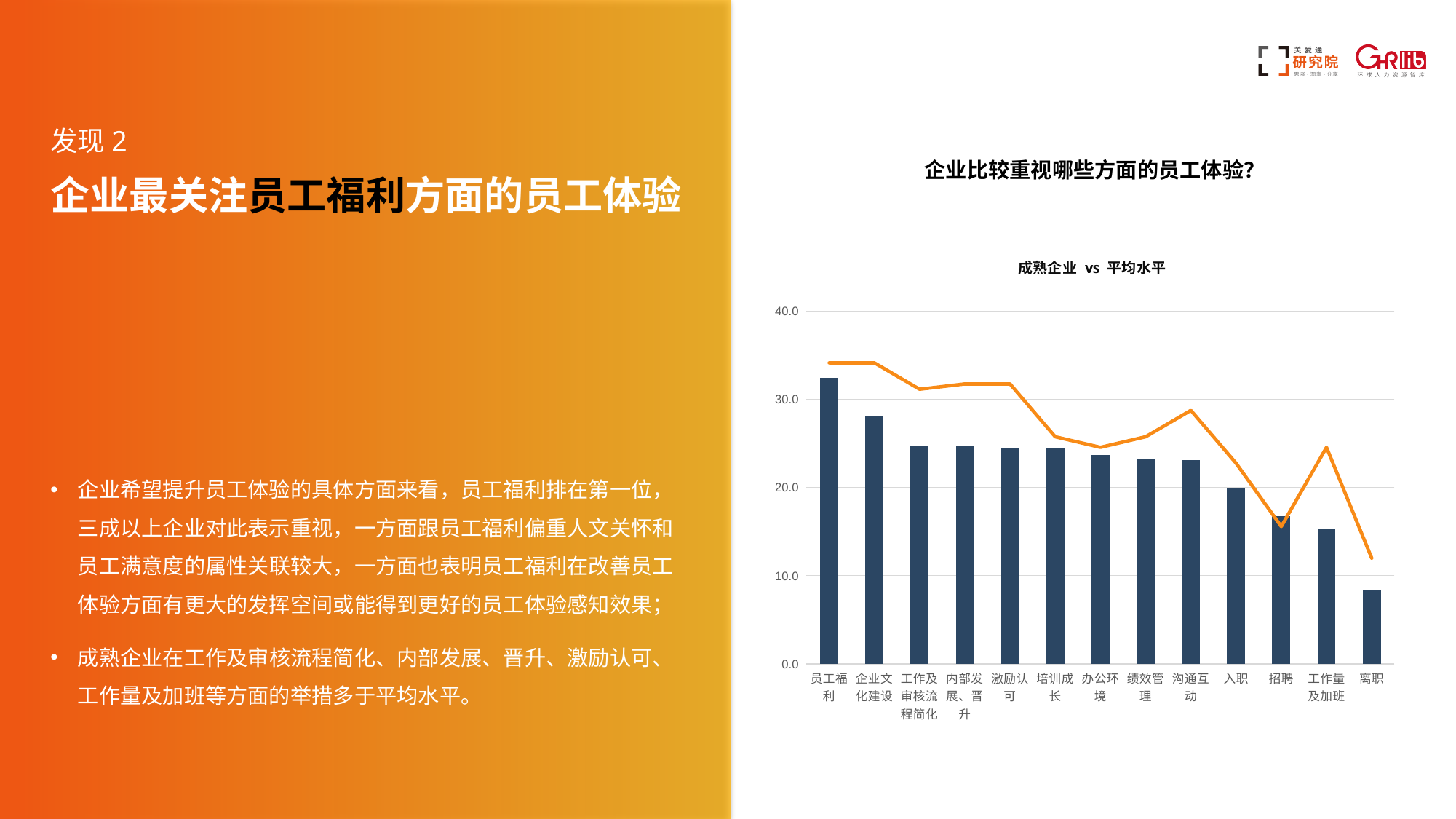
What kind of chart is shown on the slide? bar chart with a line Which has a taller bar, 企业文化建设 or 招聘? 企业文化建设 Do the bar values generally rise or fall from left to right along the x axis? fall Which category has the tallest bar in the chart? 员工福利 Is the bar value for 入职 greater or less than 30.0? less How many categories are shown on the x axis of the chart? 13 Is the bar value for 企业文化建设 greater or less than 20.0? greater Is the bar value for 离职 greater or less than 10.0? less What is the question posed as the heading above the chart? 企业比较重视哪些方面的员工体验? What is the title shown directly above the chart? 成熟企业 vs 平均水平 Which category has the shortest bar in the chart? 离职